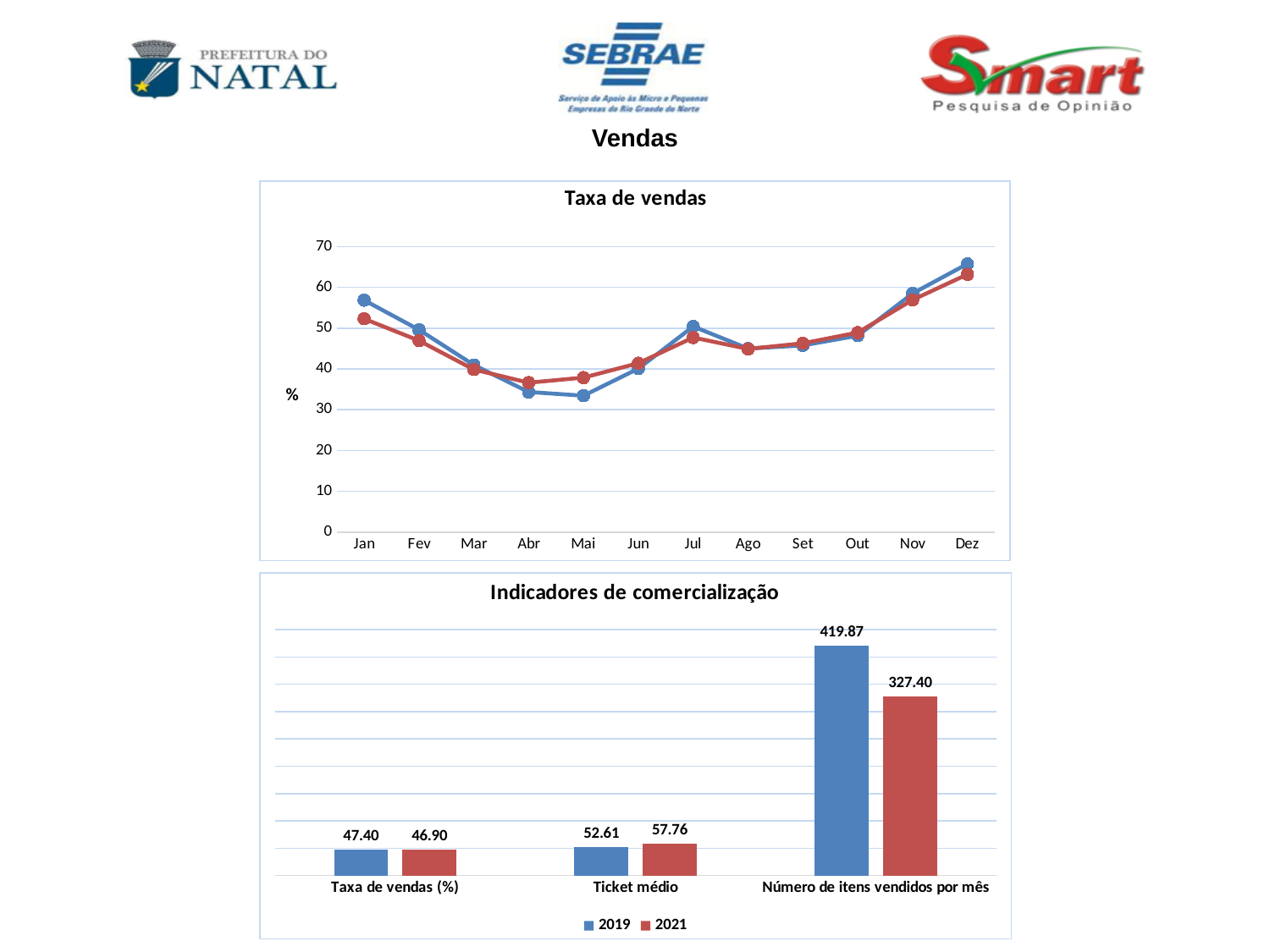
In the 'Indicadores de comercialização' chart, which is larger for 'Ticket médio': the 2019 value or the 2021 value? 2021 In the 'Taxa de vendas' chart, is the value of the blue line for Mai greater or less than 40? less In the 'Taxa de vendas' chart, do the values rise or fall from Set to Dez? rise In the 'Taxa de vendas' chart, how many months are shown on the x axis? 12 In the 'Indicadores de comercialização' chart, how many series does the legend list? 2 In the 'Indicadores de comercialização' chart, what is the difference between the 2019 and 2021 values for 'Número de itens vendidos por mês'? 92.47 In the 'Indicadores de comercialização' chart, what is the 2021 value for 'Ticket médio'? 57.76 In the 'Indicadores de comercialização' chart, what is the 2019 value for 'Número de itens vendidos por mês'? 419.87 In the 'Taxa de vendas' chart, is the value of the red line for Dez greater or less than 60? greater In the 'Indicadores de comercialização' chart, what is the 2021 value for 'Taxa de vendas (%)'? 46.90 What kind of chart is 'Taxa de vendas'? Line chart What kind of chart is 'Indicadores de comercialização'? Bar chart